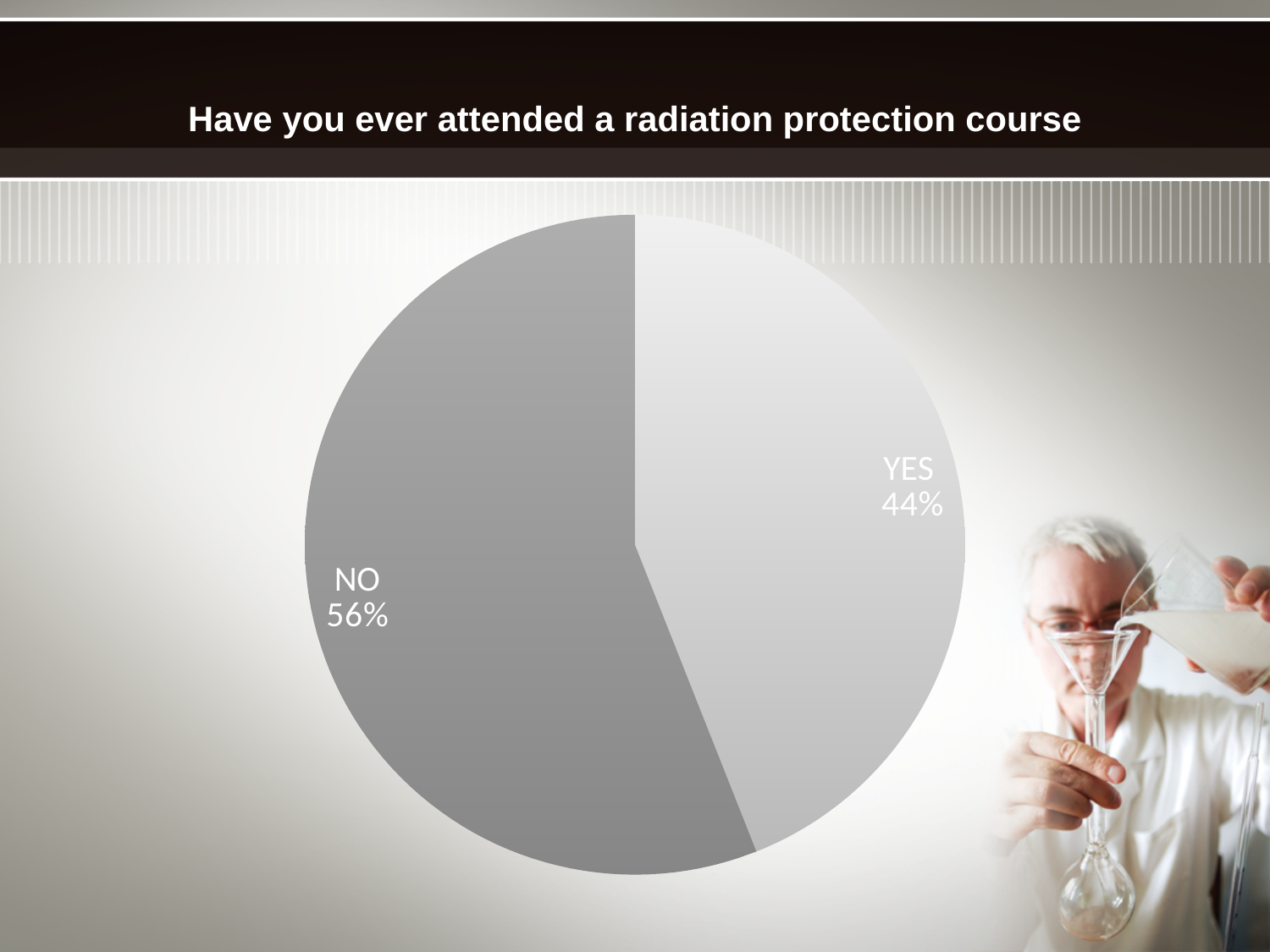
What percentage of respondents answered NO? 56% How many slices does the pie chart have? 2 What kind of chart is shown on the slide? pie chart Which slice is the largest? NO What is the difference in percentage points between the NO and YES slices? 12 Which is larger, the YES slice or the NO slice? NO What is the title of the slide containing the chart? Have you ever attended a radiation protection course What share of the pie does the YES slice represent? 44% Which slice is the smallest? YES What percentage of respondents answered YES? 44% Is the NO slice greater or less than 50% of the pie? greater